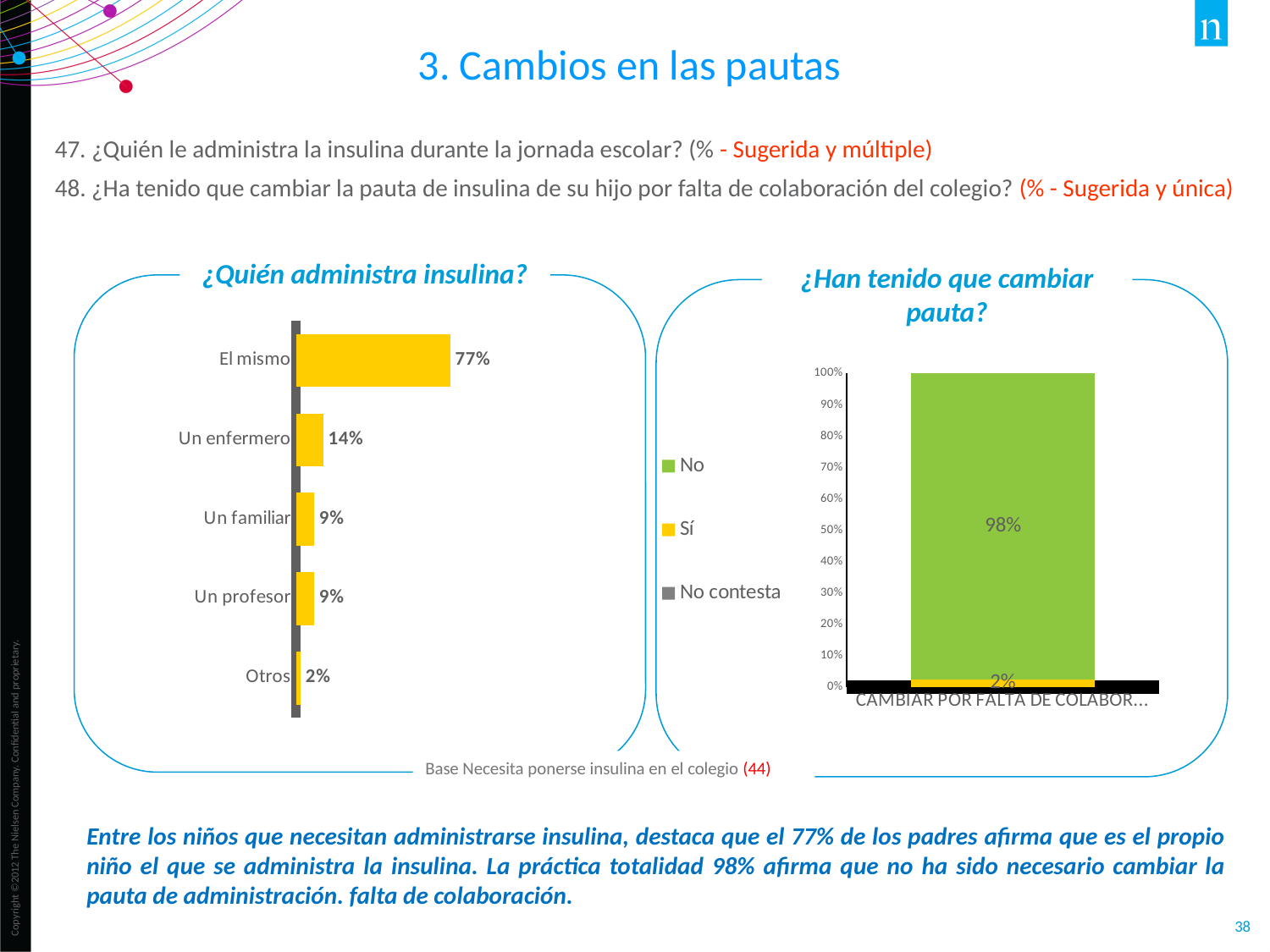
How many categories are shown in the '¿Quién administra insulina?' chart? 5 In the '¿Han tenido que cambiar pauta?' chart, what is the value for 'Sí'? 2% In the '¿Quién administra insulina?' chart, what is the value for 'Un enfermero'? 14% What kind of chart is the '¿Quién administra insulina?' chart? Bar chart In the '¿Quién administra insulina?' chart, which category has the highest value? El mismo In the '¿Quién administra insulina?' chart, which category has the lowest value? Otros How many series does the legend of the '¿Han tenido que cambiar pauta?' chart list? 3 In the '¿Quién administra insulina?' chart, what is the value for 'El mismo'? 77% In the '¿Han tenido que cambiar pauta?' chart, what is the value for 'No'? 98% In the '¿Quién administra insulina?' chart, what is the difference between 'El mismo' and 'Un enfermero'? 63% In the '¿Quién administra insulina?' chart, what is the value for 'Otros'? 2% In the '¿Quién administra insulina?' chart, which is larger: 'Un enfermero' or 'Un familiar'? Un enfermero